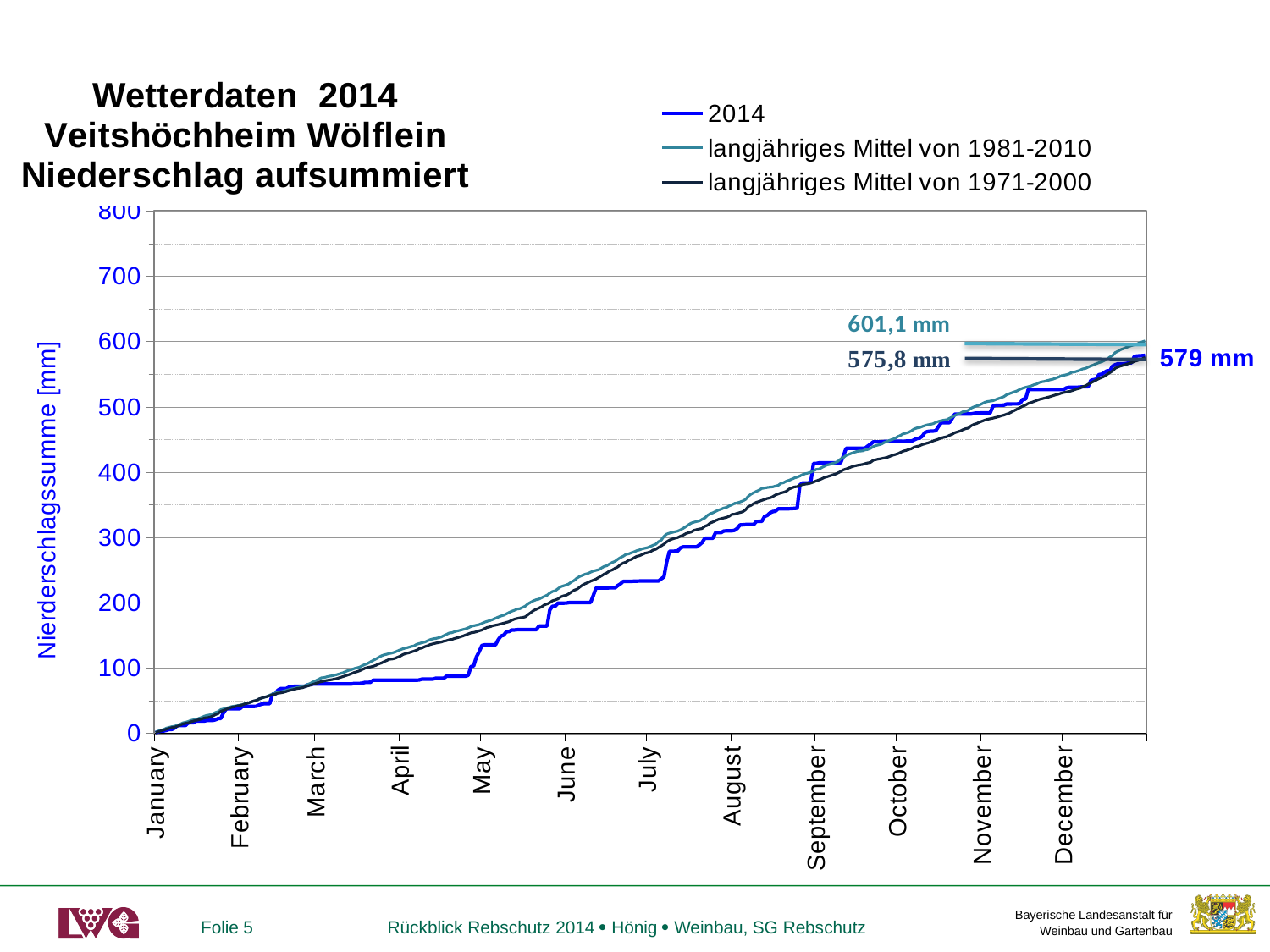
By how much does the 1981-2010 long-term mean (601,1 mm) exceed the 2014 total (579 mm)? 22,1 mm Which series ends the year with the lowest cumulative precipitation? langjähriges Mittel von 1971-2000 What final value is labelled for the series 'langjähriges Mittel von 1971-2000'? 575,8 mm What final value is labelled for the series 'langjähriges Mittel von 1981-2010'? 601,1 mm Which series ends the year with the highest cumulative precipitation? langjähriges Mittel von 1981-2010 What kind of chart is shown on the slide? line chart How many months are labelled on the x axis? 12 Which is larger at year end: the 2014 total or the 1971-2000 long-term mean? 2014 What is the cumulative precipitation for 2014 at the end of the year, as labelled on the chart? 579 mm Do the plotted values rise or fall from January to December? rise Is the cumulative 2014 precipitation at the July tick greater or less than 300? less How many series does the legend list? 3